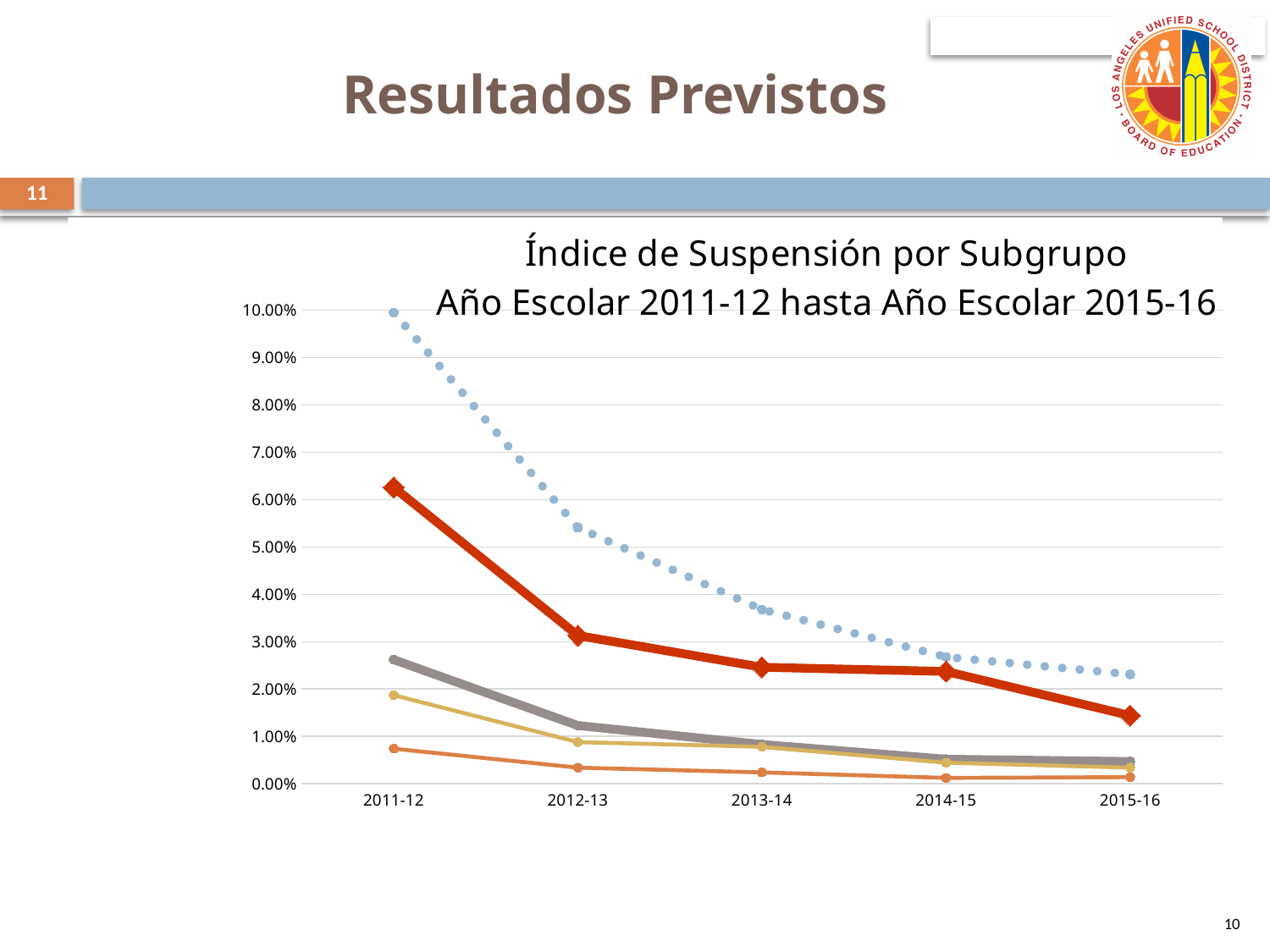
Is the value of the dotted blue line for 2015-16 greater or less than 3.00%? less How many school years are shown on the x axis of the chart? 5 How many lines are plotted on the chart? 5 In which school year does the thick red line reach its highest value? 2011-12 Is the value of the thick red line for 2015-16 greater or less than 2.00%? less Is the value of the thick red line for 2011-12 greater or less than 5.00%? greater Do the suspension rates rise or fall from 2011-12 to 2015-16? Fall What is the title of the chart? Índice de Suspensión por Subgrupo Año Escolar 2011-12 hasta Año Escolar 2015-16 In 2012-13, which is larger: the value of the thick red line or the value of the gray line? The thick red line What kind of chart is shown on the slide? Line chart